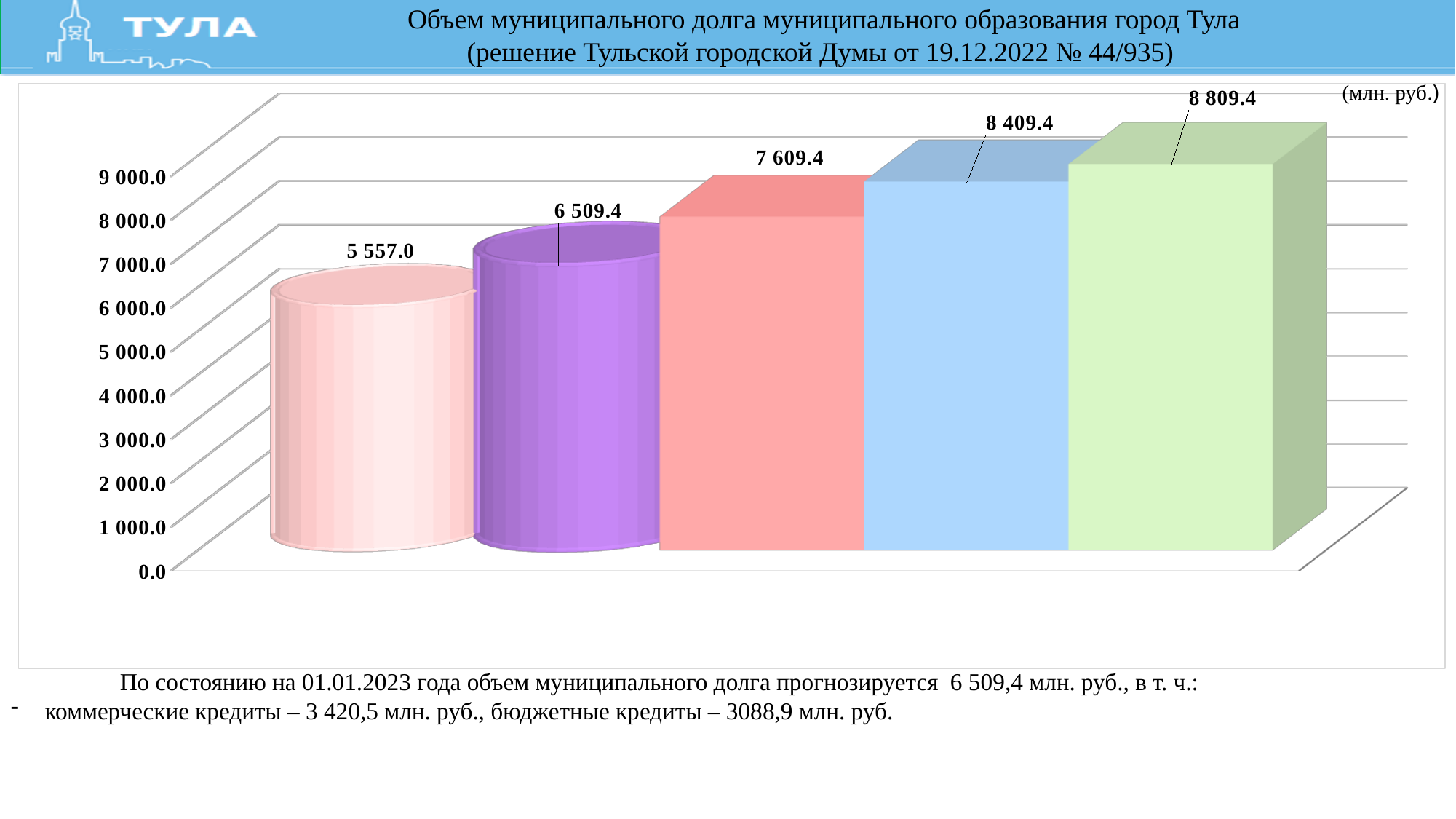
What is the value of the second (purple) bar? 6 509.4 What is the value of the last (rightmost, green) bar? 8 809.4 How many bars are plotted in the chart? 5 What unit of measurement is indicated in the top right corner of the chart? млн. руб. What is the difference between the value of the green bar and the value of the blue bar? 400.0 What is the value of the first (leftmost, pink) bar? 5 557.0 What is the value of the fourth (blue) bar? 8 409.4 Do the values rise or fall from left to right across the chart? rise What type of chart is shown on the slide? bar chart Which bar has the lowest value? the leftmost (pink) bar, 5 557.0 What is the value of the third (red) bar? 7 609.4 Which bar has the highest value? the rightmost (green) bar, 8 809.4